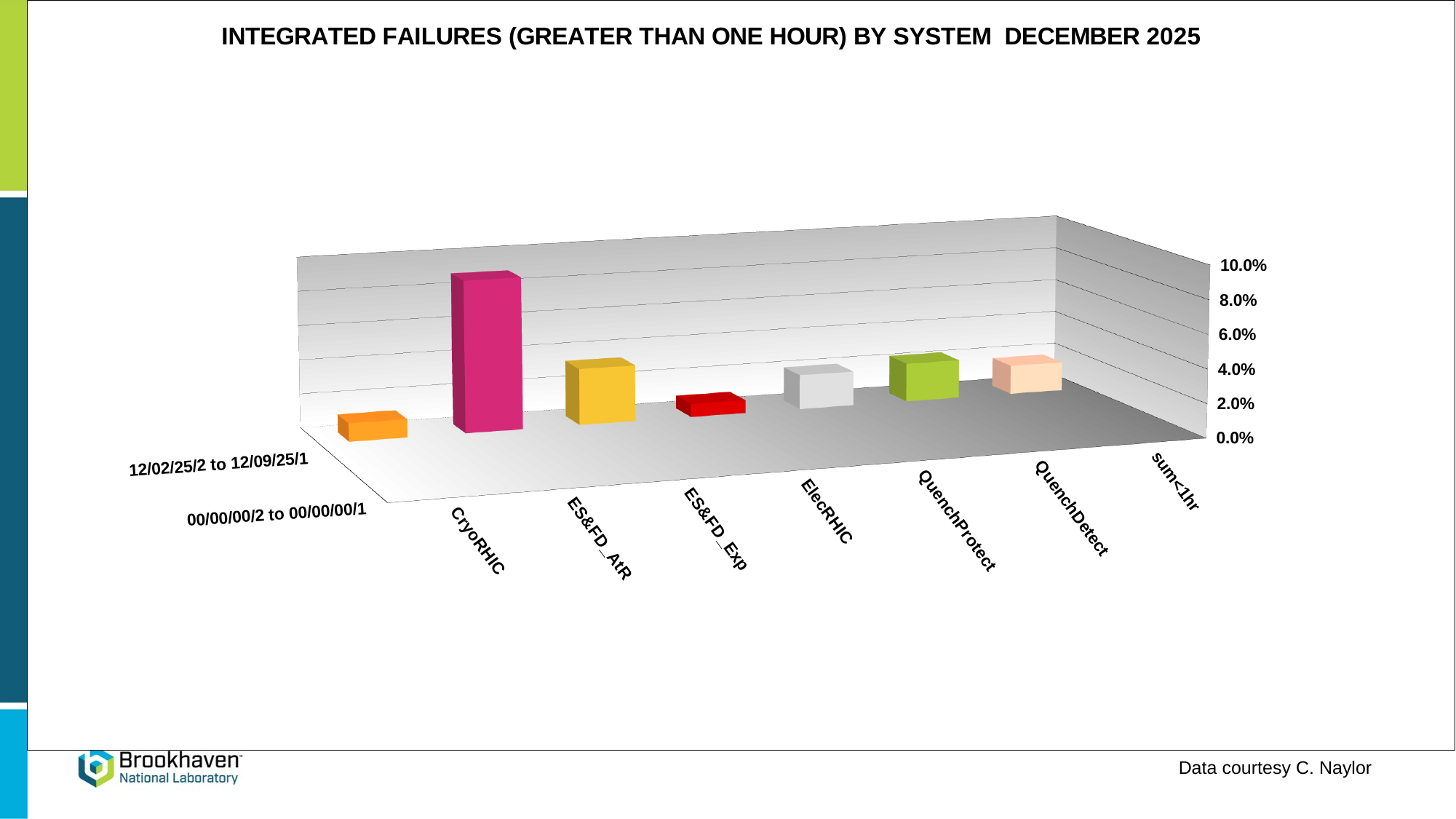
Is the value for QuenchProtect greater or less than 4.0%? less What is the title of the chart? INTEGRATED FAILURES (GREATER THAN ONE HOUR) BY SYSTEM DECEMBER 2025 Is the value for CryoRHIC greater or less than 2.0%? less How many system categories are shown along the x axis of the chart? 7 Is the value for ES&FD_AtR greater or less than 6.0%? greater Which system has the highest bar in the chart? ES&FD_AtR Which is larger, the value for ES&FD_AtR or the value for ES&FD_Exp? ES&FD_AtR What kind of chart is shown on the slide? bar chart What is the highest value labelled on the vertical axis of the chart? 10.0% Which is larger, the value for QuenchProtect or the value for CryoRHIC? QuenchProtect